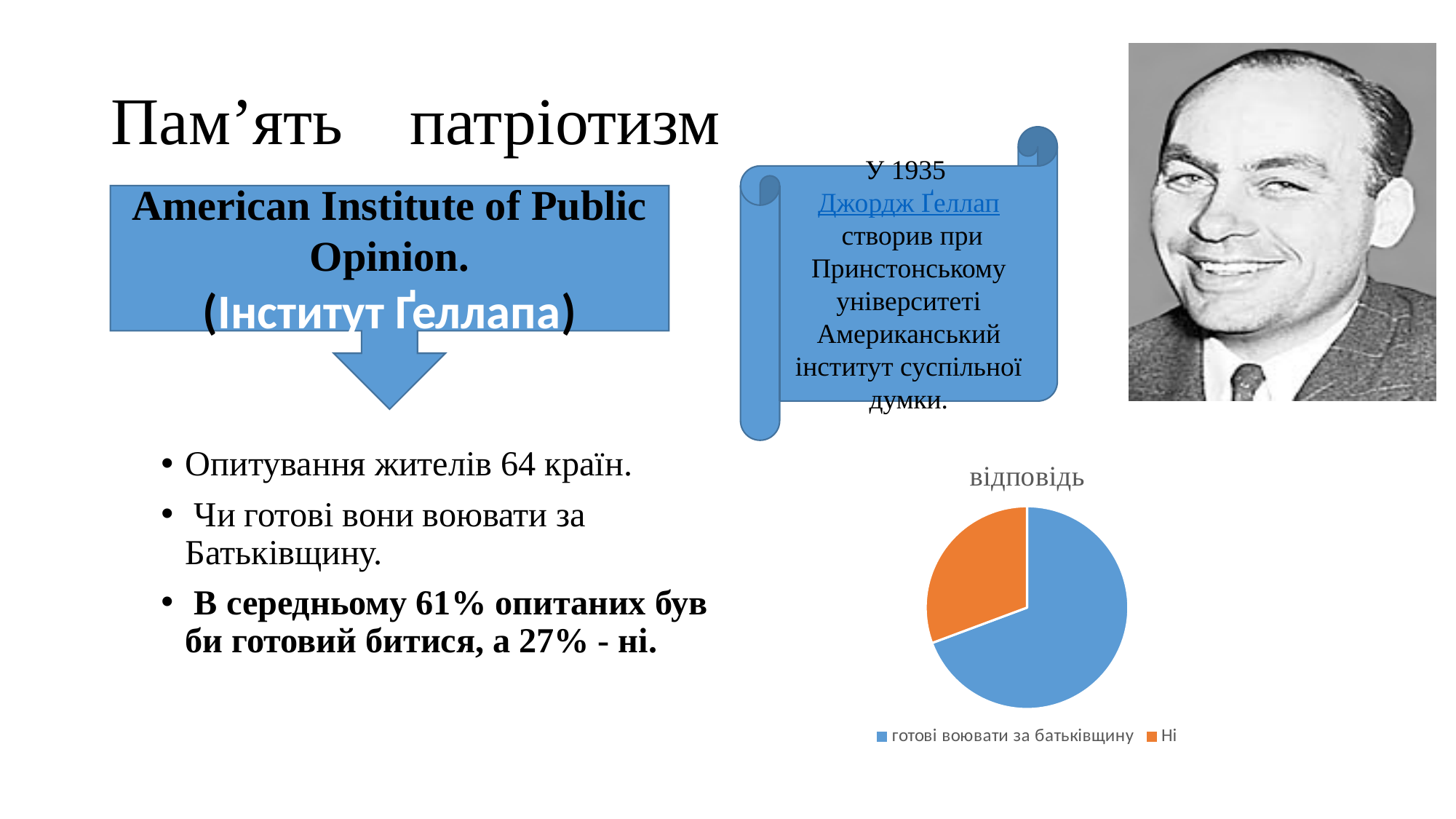
Which slice is larger in the pie chart: "готові воювати за батьківщину" or "Ні"? готові воювати за батьківщину How many slices does the pie chart have? 2 What is the title of the pie chart? відповідь What colour is the "Ні" slice in the pie chart? orange Which slice of the pie chart is the largest? готові воювати за батьківщину What kind of chart is shown on the slide? pie chart Which slice of the pie chart is the smallest? Ні How many entries does the legend of the pie chart list? 2